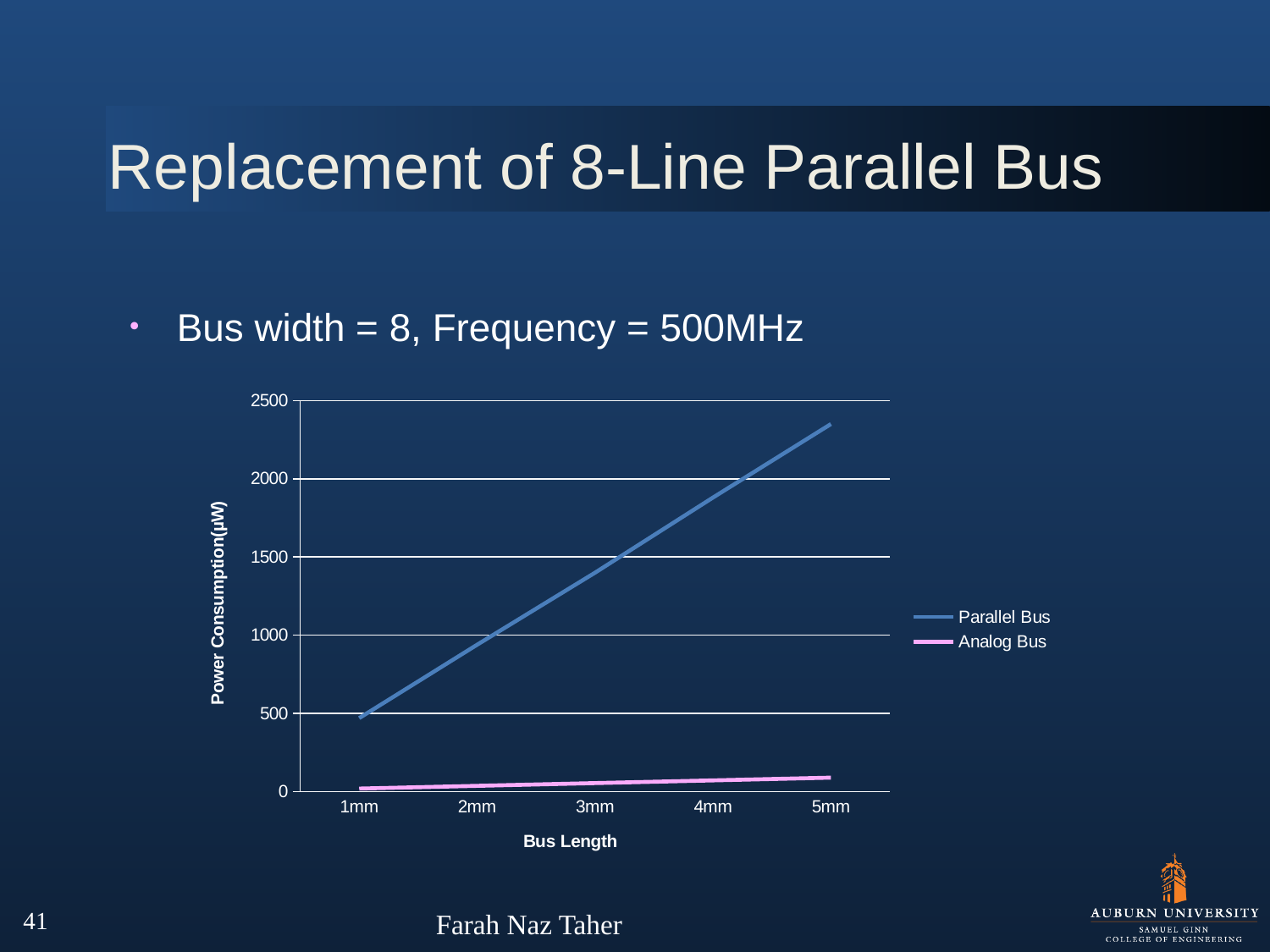
Is the Parallel Bus power consumption at 5mm greater or less than 2000? greater How many bus length points are plotted along the x axis? 5 Does the Parallel Bus power consumption rise or fall as bus length increases from 1mm to 5mm? rise At which bus length is the Parallel Bus power consumption highest? 5mm What kind of chart is shown on the slide? line chart At which bus length is the Parallel Bus power consumption lowest? 1mm At 5mm bus length, which series has the higher power consumption, Parallel Bus or Analog Bus? Parallel Bus Is the Parallel Bus power consumption at 3mm greater or less than 1000? greater What is the title of the vertical axis? Power Consumption(µW) Which series is drawn in pink in the legend? Analog Bus How many series does the chart legend list? 2 Is the Analog Bus power consumption at 5mm greater or less than 500? less